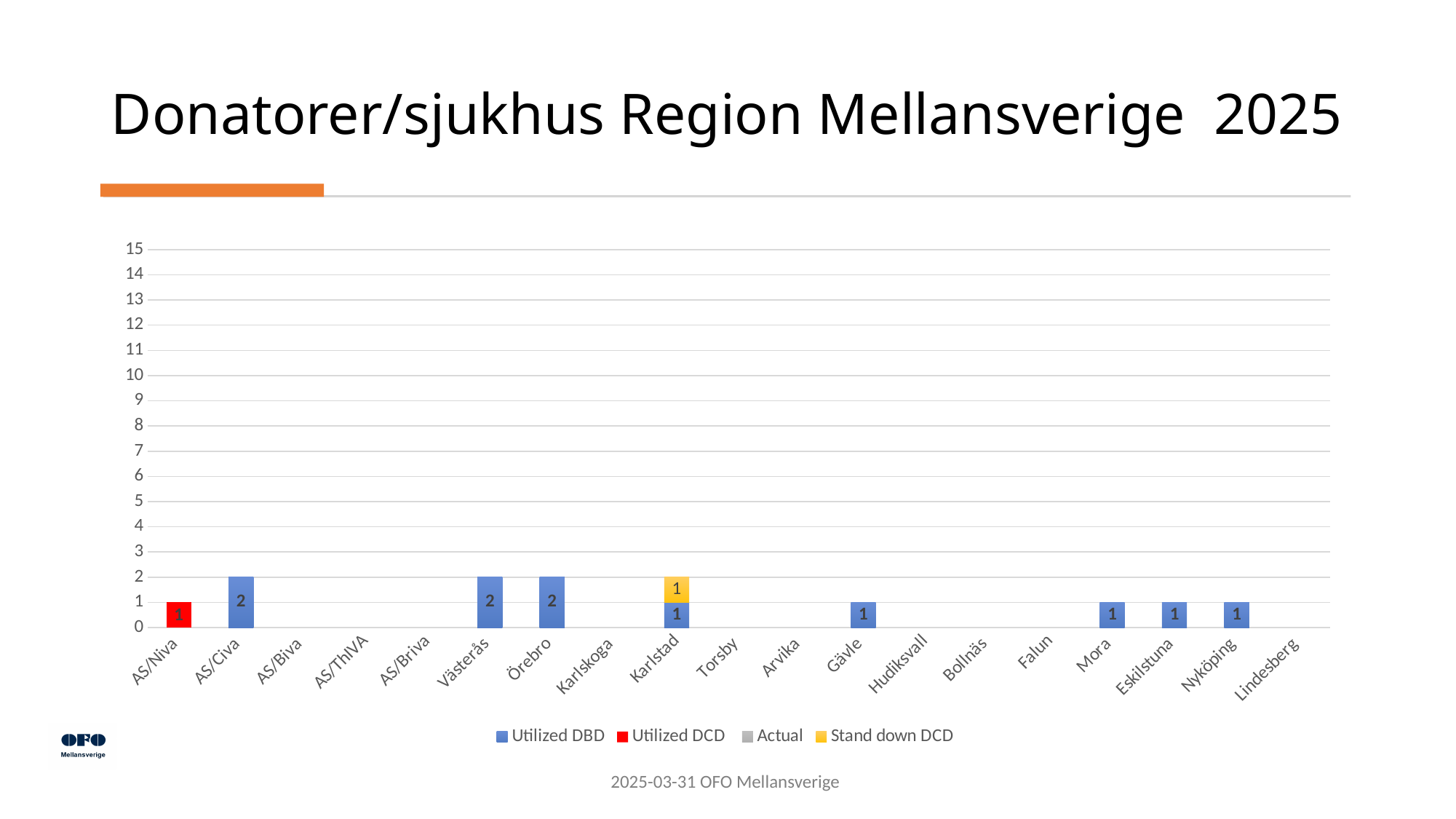
Which is larger, the Utilized DBD value for Örebro or the Utilized DBD value for Eskilstuna? Örebro What kind of chart is shown on the slide? Stacked bar chart What is the Stand down DCD value for Karlstad? 1 What is the difference between the Utilized DBD value for Västerås and the Utilized DBD value for Mora? 1 How many categories are shown on the x axis? 19 What is the Utilized DBD value for AS/Civa? 2 How many series does the legend list? 4 What is the title of the chart? Donatorer/sjukhus Region Mellansverige 2025 Which colour represents the Stand down DCD series in the legend? Yellow What is the Utilized DBD value for Gävle? 1 What is the total of the stacked bar for Karlstad? 2 What is the Utilized DCD value for AS/Niva? 1